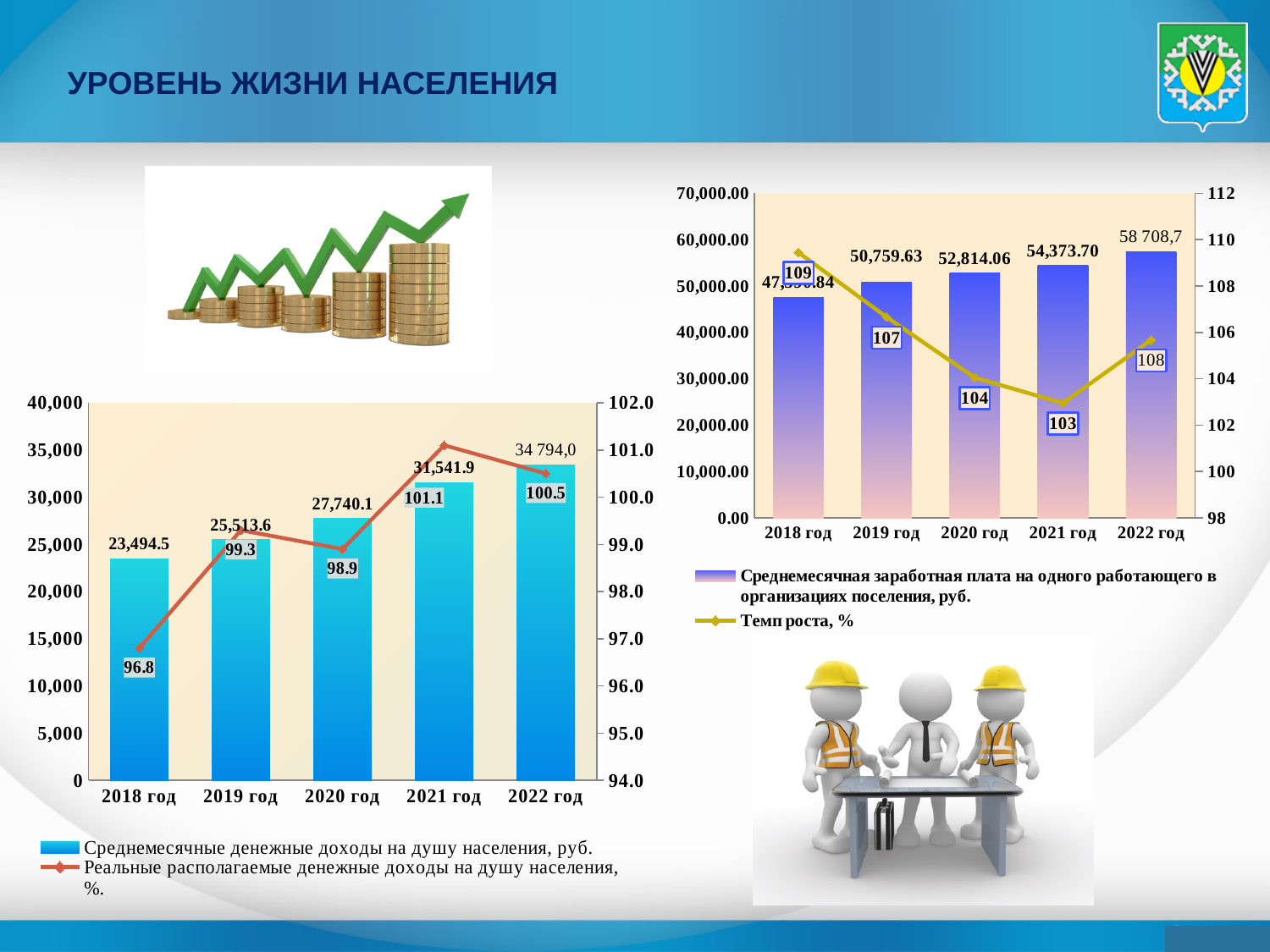
On the right chart, how many years are shown on the x axis? 5 On the right chart, which year has the highest average monthly wage bar? 2022 год On the right chart, is the wage bar for 2019 год greater or less than 50,000.00? greater On the left chart, what is the real disposable income percentage for 2021 год? 101.1 On the left chart, which year has the lowest real disposable income percentage on the line? 2018 год On the right chart, which year has the lowest growth rate on the line? 2021 год On the left chart, do the income bars rise or fall from 2018 год to 2022 год? rise On the left chart, what is the difference between the income bars for 2021 год and 2020 год? 3,801.8 On the left chart, what is the value of the average monthly per-capita income bar for 2020 год? 27,740.1 On the left chart, how many series does the legend list? 2 On the right chart, what is the average monthly wage for 2021 год? 54,373.70 On the right chart, what is the growth rate (Темп роста, %) for 2020 год? 104